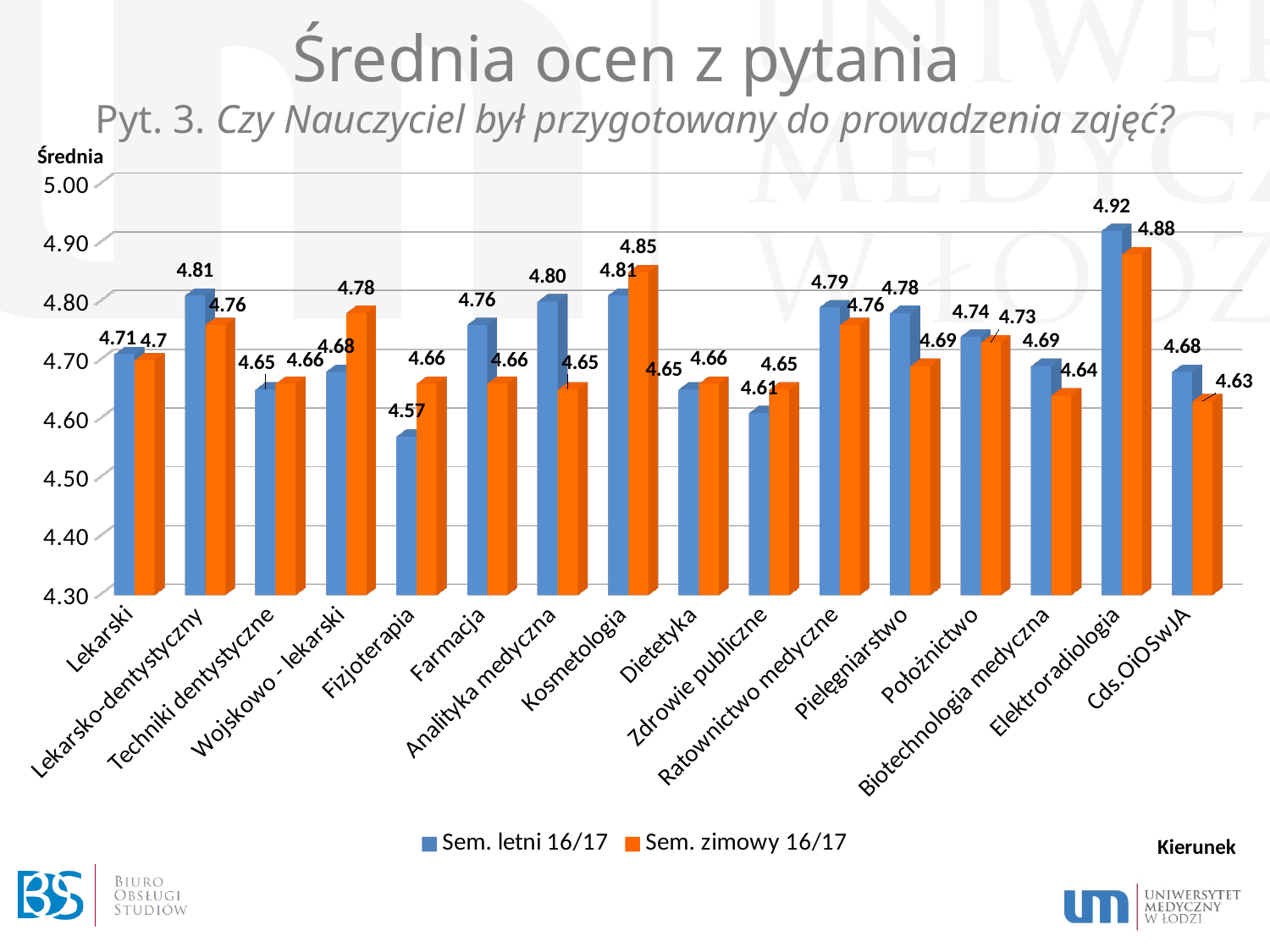
How many categories (kierunki) are shown on the x axis? 16 Which category has the lowest Sem. letni 16/17 value? Fizjoterapia What is the Sem. letni 16/17 value for Fizjoterapia? 4.57 Which category has the lowest Sem. zimowy 16/17 value? Cds.OiOSwJA Which colour represents Sem. zimowy 16/17 in the chart? Orange What is the difference between the Sem. zimowy 16/17 and Sem. letni 16/17 values for Analityka medyczna? 0.15 Which category has the highest Sem. letni 16/17 value? Elektroradiologia How many series does the legend list? 2 What is the Sem. letni 16/17 value for Elektroradiologia? 4.92 What kind of chart is shown on the slide? Bar chart What is the Sem. zimowy 16/17 value for Kosmetologia? 4.85 For Wojskowo - lekarski, which series has the larger value: Sem. letni 16/17 or Sem. zimowy 16/17? Sem. zimowy 16/17